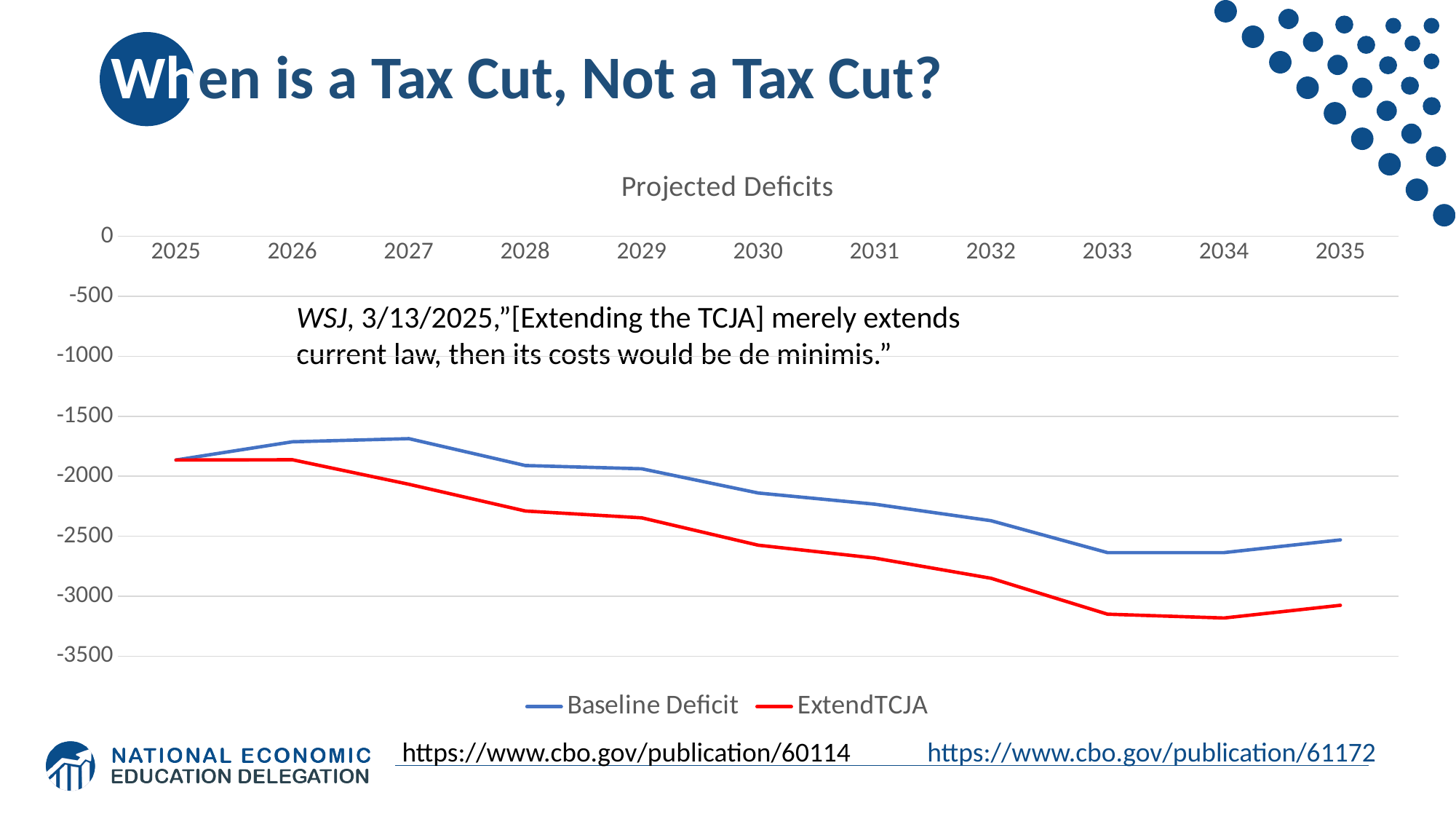
In 2030, which series has the higher (less negative) value, Baseline Deficit or ExtendTCJA? Baseline Deficit Is the value for ExtendTCJA in 2028 greater or less than -2500? greater Is the value for Baseline Deficit in 2030 greater or less than -2000? less How many years are shown on the x axis? 11 Does the Baseline Deficit line rise or fall from 2027 to 2033? fall Is the value for ExtendTCJA in 2033 greater or less than -3000? less What is the title of the chart? Projected Deficits What kind of chart is shown on the slide? line chart Which series is drawn in red? ExtendTCJA How many series does the legend list? 2 Does the ExtendTCJA line rise or fall from 2026 to 2034? fall